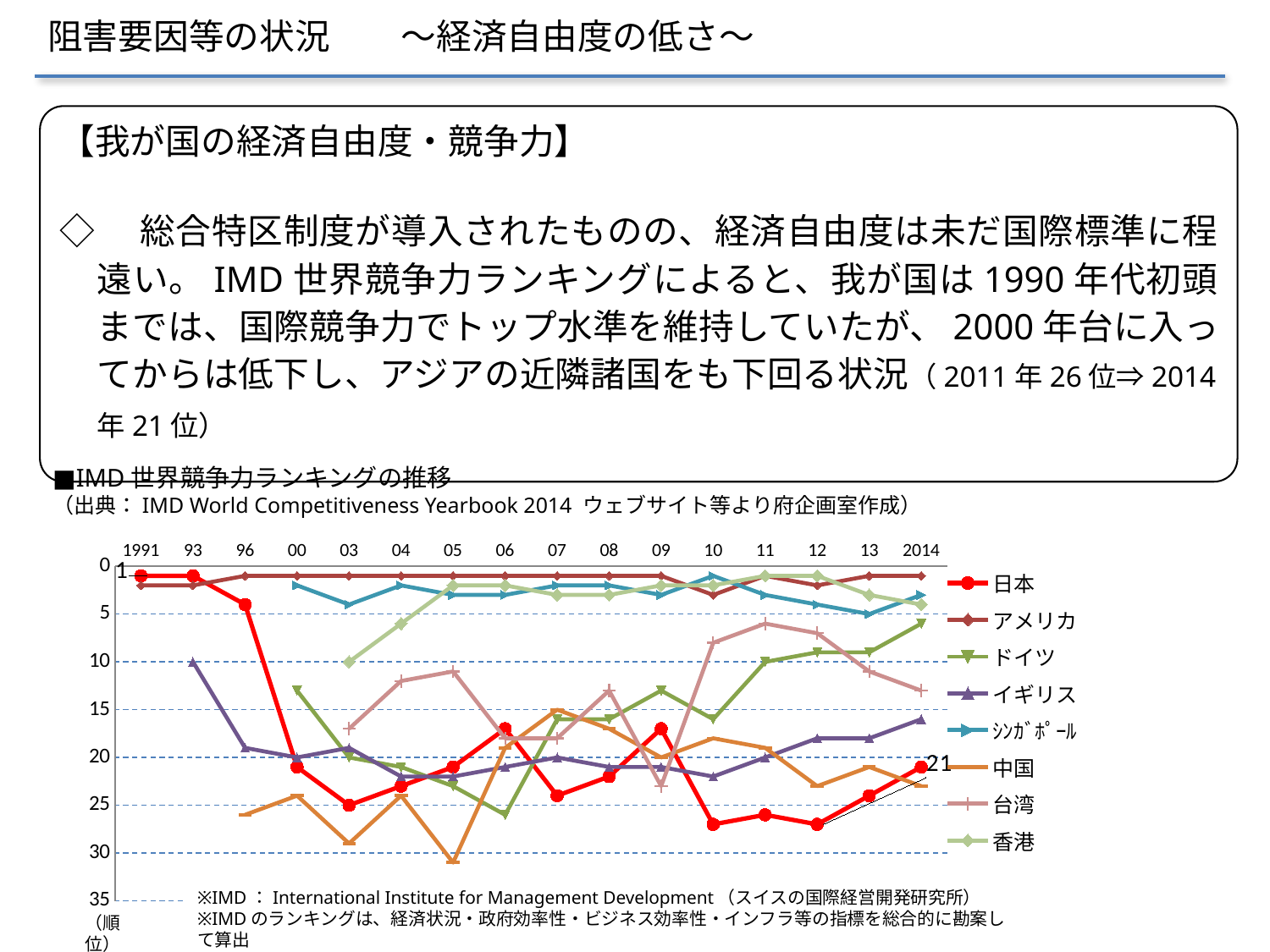
What colour is the line for 日本 in the chart? red How many series does the legend of the IMD ranking chart list? 8 What kind of chart is shown on the slide? line chart Which series has the highest plotted value in 2012? 日本 What is the difference between the value for 日本 in 2014 and in 1991? 20 Is the value for 日本 in 2009 greater or less than 20? less What is the plotted value for 日本 in 1991? 1 How many year points are shown along the x axis of the chart? 16 Is the value for 中国 in 2012 greater or less than 20? greater What is the plotted value for 日本 in 2014? 21 Is the value for 日本 in 2012 greater or less than 25? greater Which is larger, the value for 日本 in 2014 or the value for 日本 in 1991? 2014